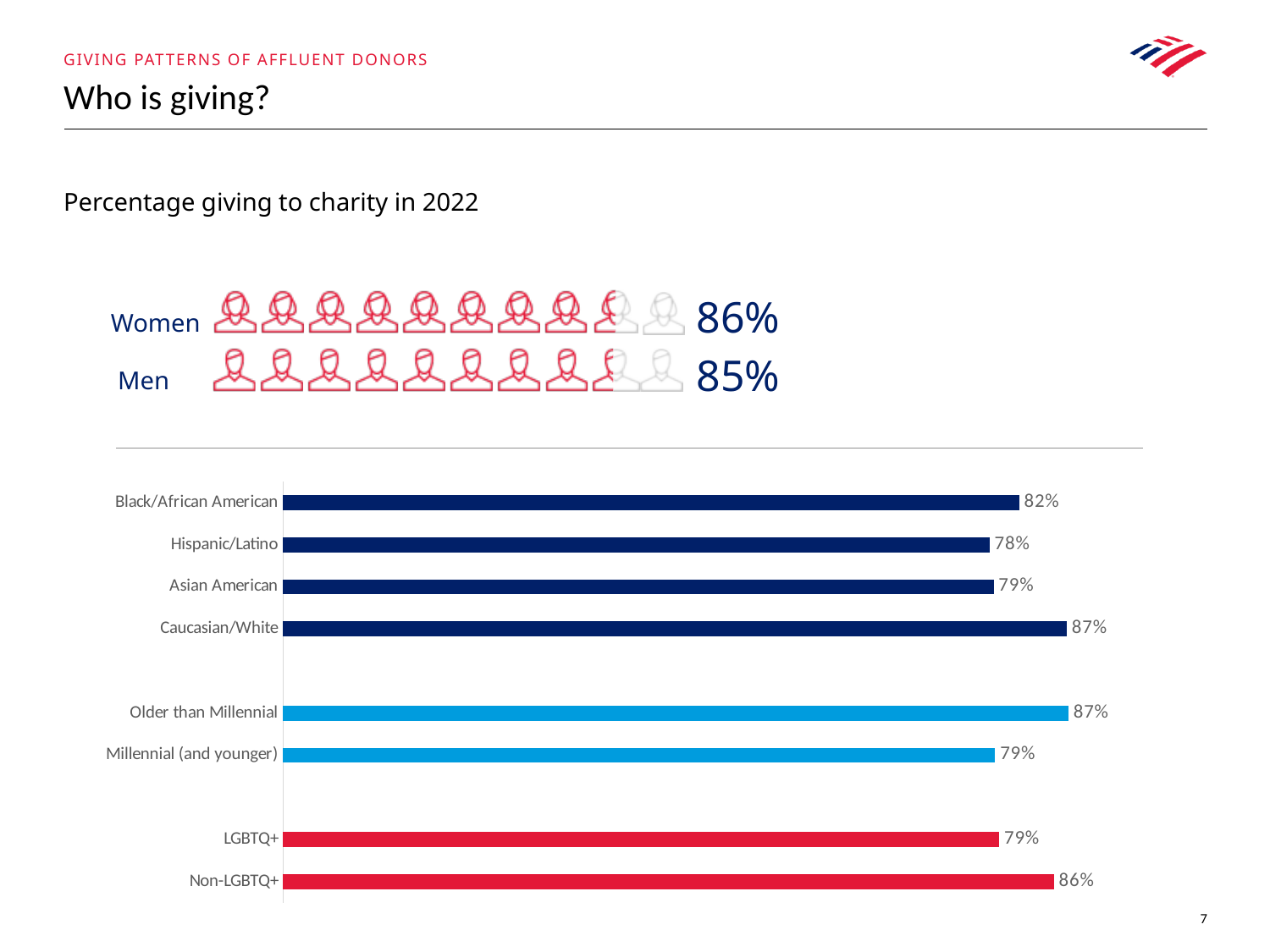
In the bar chart, what is the value shown for Hispanic/Latino? 78% In the bar chart, what is the difference between Older than Millennial and Millennial (and younger)? 8 percentage points In the bar chart, what is the difference between the Non-LGBTQ+ and LGBTQ+ values? 7 percentage points According to the pictograph at the top of the slide, what percentage of women gave to charity in 2022? 86% In the bar chart, what percentage of Black/African American affluent donors gave to charity in 2022? 82% What kind of chart is used to show giving by race, generation and LGBTQ+ status? Bar chart In the bar chart, which category has the lowest percentage giving to charity? Hispanic/Latino According to the pictograph at the top of the slide, what percentage of men gave to charity in 2022? 85% In the bar chart, which is larger, the value for Black/African American or the value for Asian American? Black/African American In the bar chart, what is the value for Millennial (and younger)? 79% In the bar chart, what is the value for Non-LGBTQ+? 86% How many categories are shown in the bar chart? 8